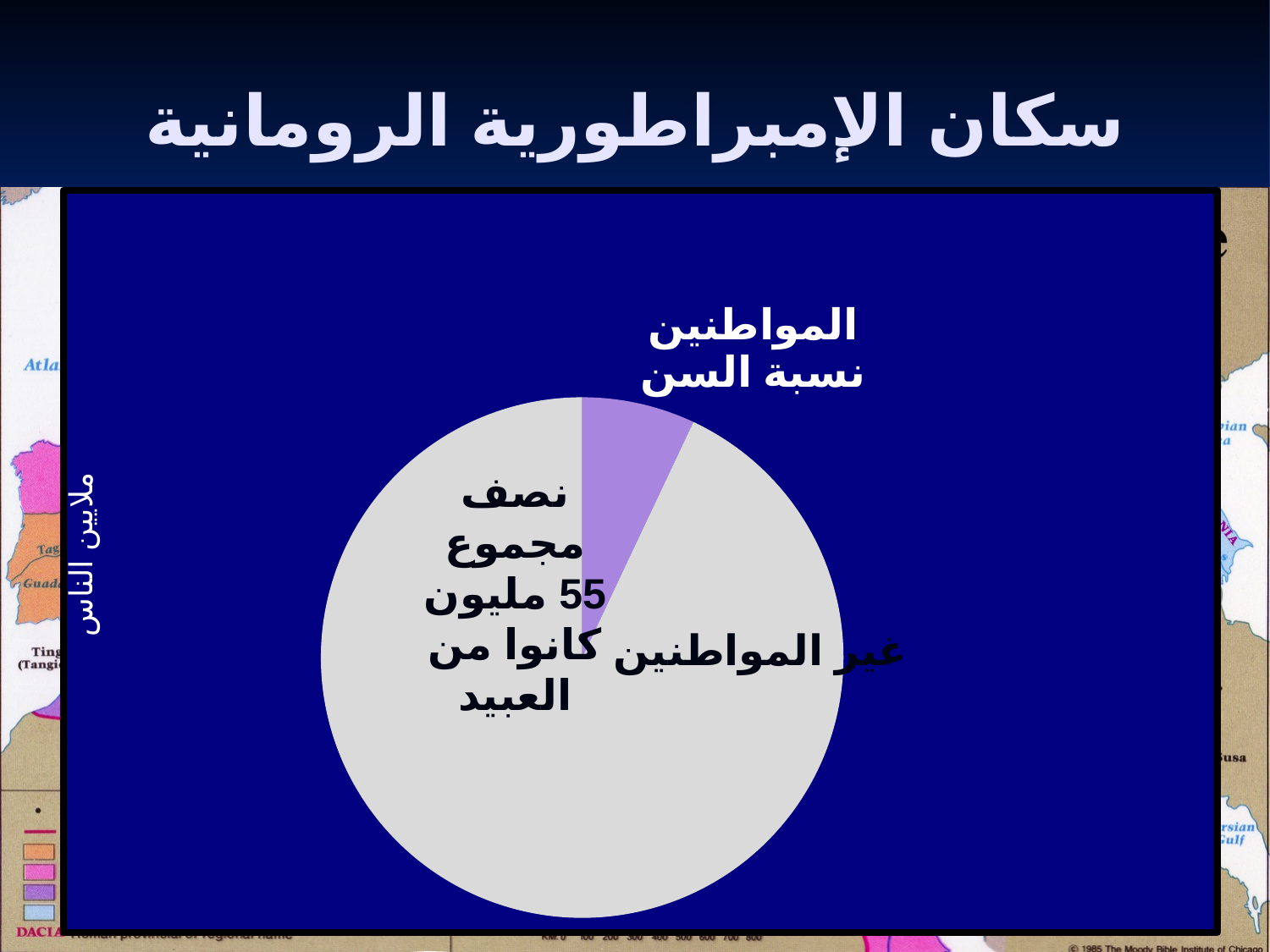
Which slice is larger, المواطنين or غير المواطنين? غير المواطنين Which slice of the pie chart is the largest? غير المواطنين How many slices does the pie chart have? 2 What kind of chart is shown on the slide? pie chart Which slice of the pie chart is the smallest? المواطنين What colour is the slice for غير المواطنين? grey What is the title of the slide containing the pie chart? سكان الإمبراطورية الرومانية Does the slice for المواطنين represent more or less than half of the pie? less